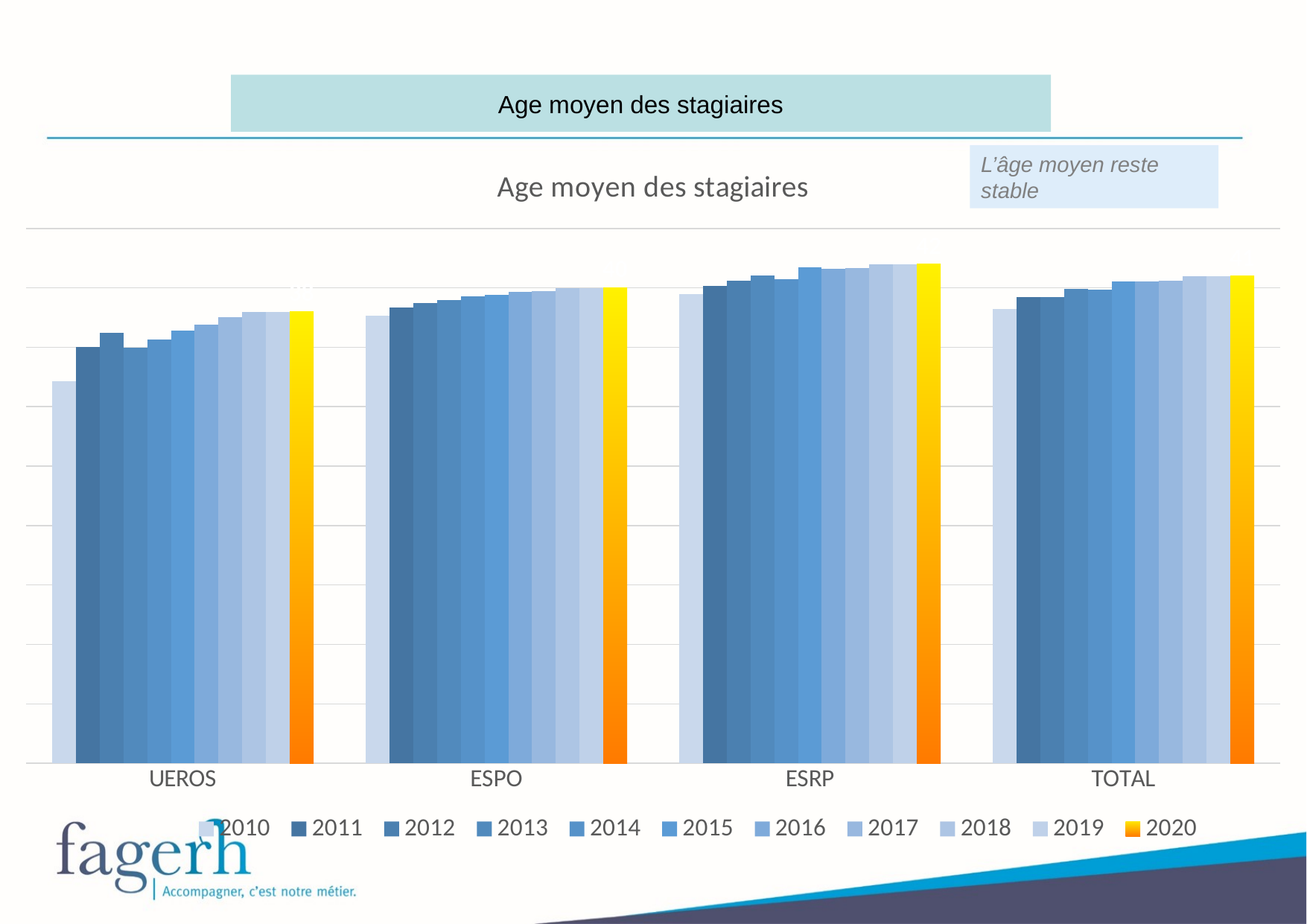
What kind of chart is shown on the slide? Bar chart What is the title of the chart? Age moyen des stagiaires For TOTAL, which year has the larger value: 2010 or 2020? 2020 How many series does the chart's legend list? 11 For UEROS, which year has the larger value: 2010 or 2011? 2011 For 2010, which category has the larger value: UEROS or ESRP? ESRP For ESPO, do the values generally rise or fall from 2010 to 2020? Rise How many categories are shown on the x axis of the chart? 4 Which category has the highest bars overall in the chart? ESRP For UEROS, which year has the lowest value? 2010 Which colour is used for the 2020 series in the chart? Yellow/orange Which category has the lowest bars overall in the chart? UEROS